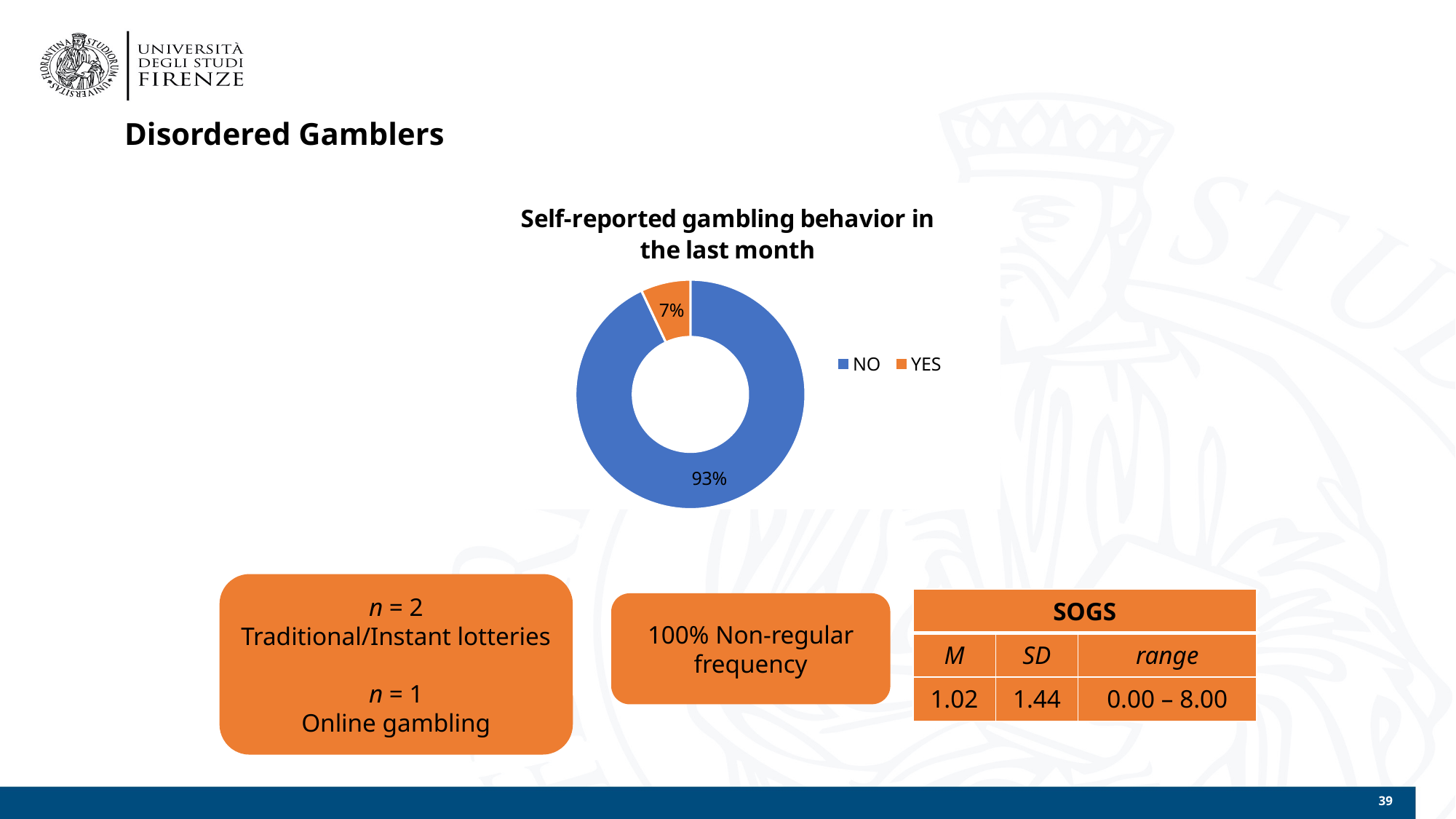
What is the difference in percentage points between the NO and YES shares? 86 What percentage of the chart is labelled NO? 93% What percentage of the chart is labelled YES? 7% What is the share of the chart taken by the YES segment? 7% How many categories does the chart show? 2 What kind of chart is shown on the slide? doughnut chart Which category has the smallest share of the chart? YES How many entries does the legend list? 2 Which is larger, the NO share or the YES share? NO What colour is the YES segment of the chart? orange Which category has the largest share of the chart? NO What is the title of the chart? Self-reported gambling behavior in the last month